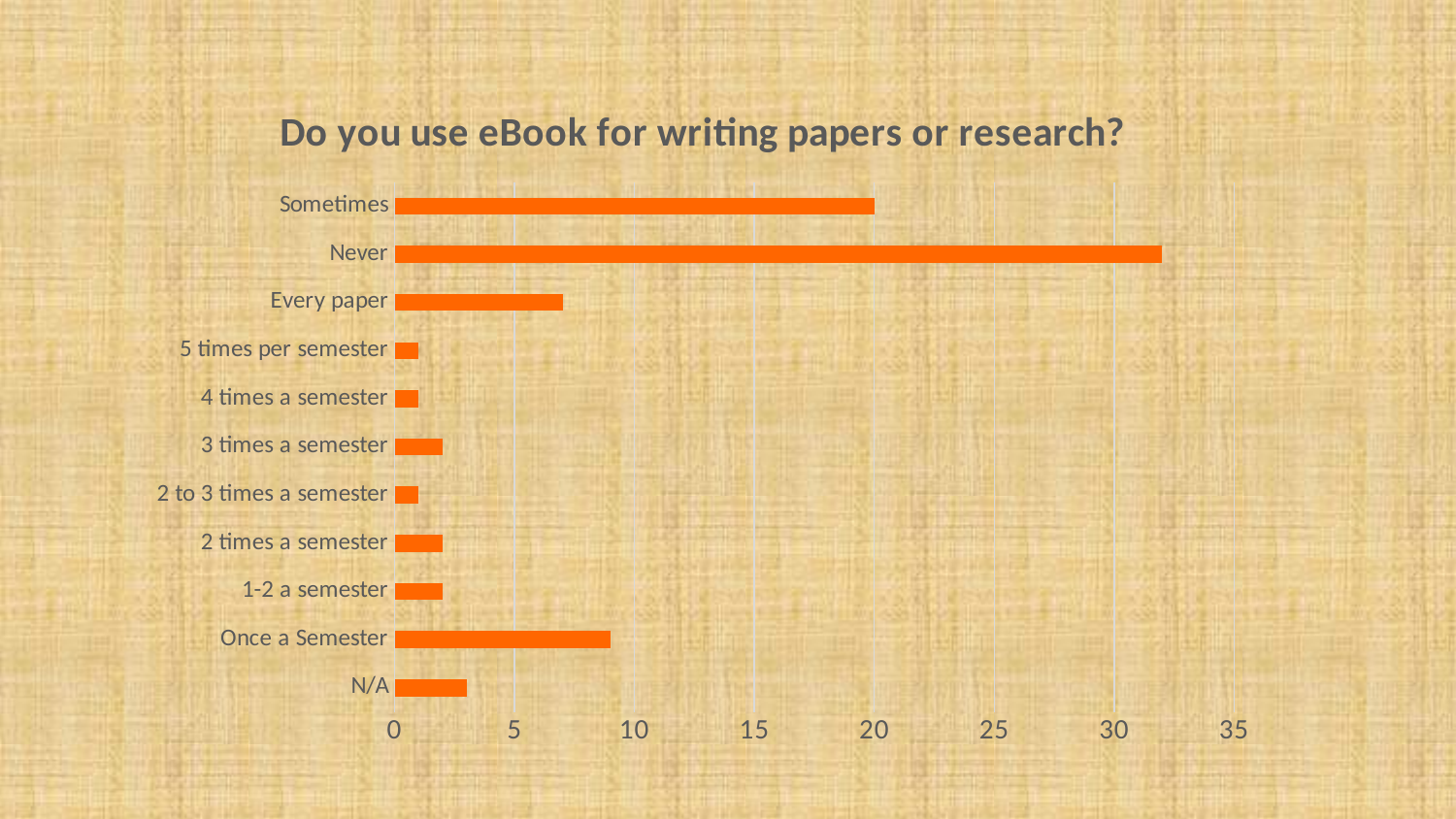
Is the value for Never greater or less than 30? greater Which is larger, the value for Never or the value for Sometimes? Never Is the value for Every paper greater or less than 5? greater How many categories are shown on the chart? 11 What colour are the bars in the chart? orange What is the title of the chart? Do you use eBook for writing papers or research? Which is larger, the value for Once a Semester or the value for Every paper? Once a Semester What kind of chart is shown on the slide? bar chart What is the value for Sometimes? 20 Is the value for Once a Semester greater or less than 10? less Which category has the highest value? Never